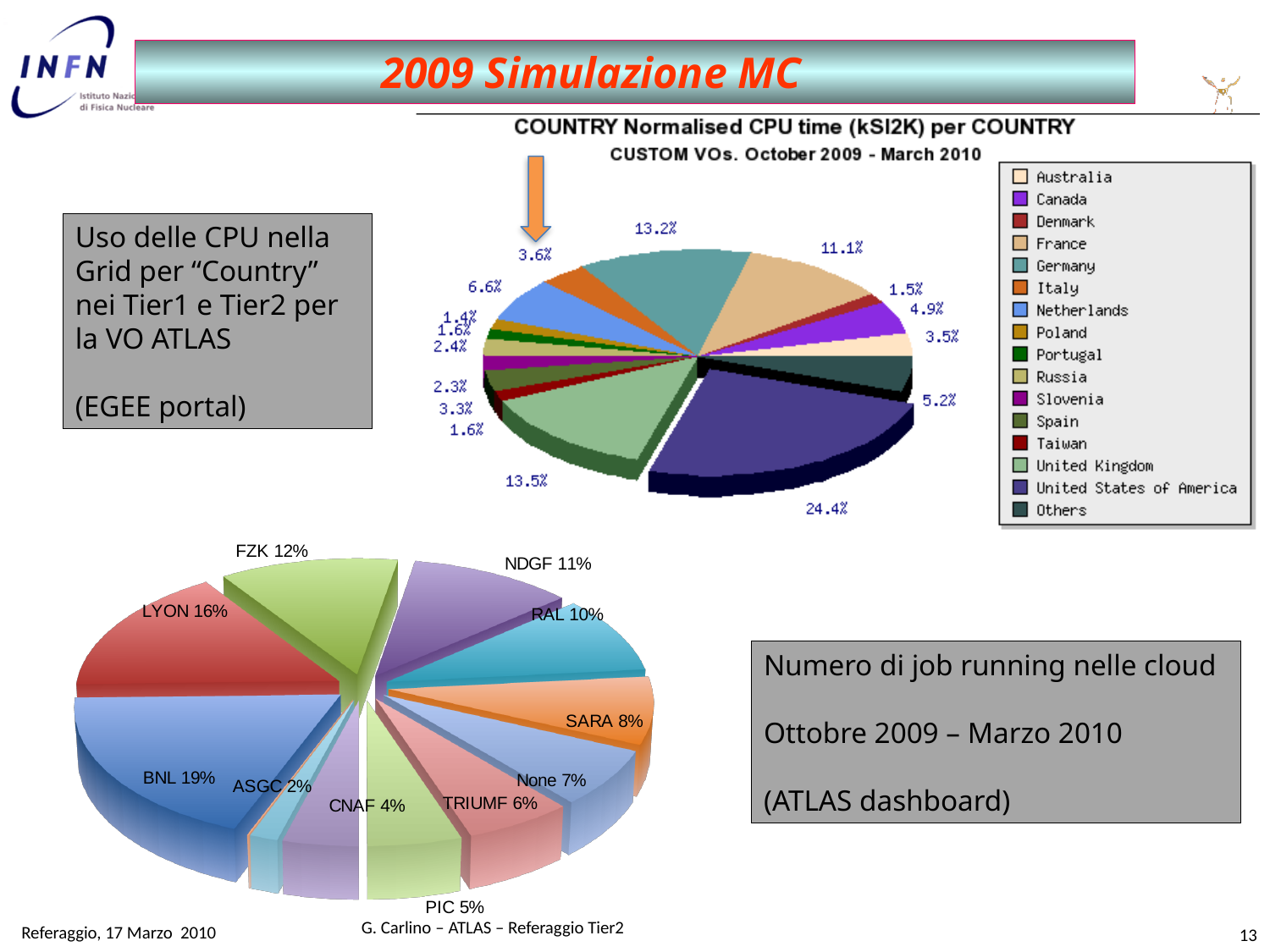
What type of chart is used for the number of running jobs per cloud at the bottom of the slide? Pie chart In the top chart 'COUNTRY Normalised CPU time (kSI2K) per COUNTRY', how many entries does the legend list? 16 In the bottom pie chart (number of running jobs per cloud), which has the larger share, RAL or SARA? RAL In the bottom pie chart (number of running jobs per cloud), which cloud has the largest share? BNL In the bottom pie chart (number of running jobs per cloud), what share does CNAF have? 4% In the bottom pie chart (number of running jobs per cloud), what share does BNL have? 19% In the top chart 'COUNTRY Normalised CPU time (kSI2K) per COUNTRY', what percentage is shown for the slice the orange arrow points to (Italy)? 3.6% In the bottom pie chart (number of running jobs per cloud), how many percentage points larger is LYON's share than FZK's? 4 percentage points In the bottom pie chart (number of running jobs per cloud), what share does LYON have? 16% In the top chart 'COUNTRY Normalised CPU time (kSI2K) per COUNTRY', what is the percentage of the largest slice? 24.4%